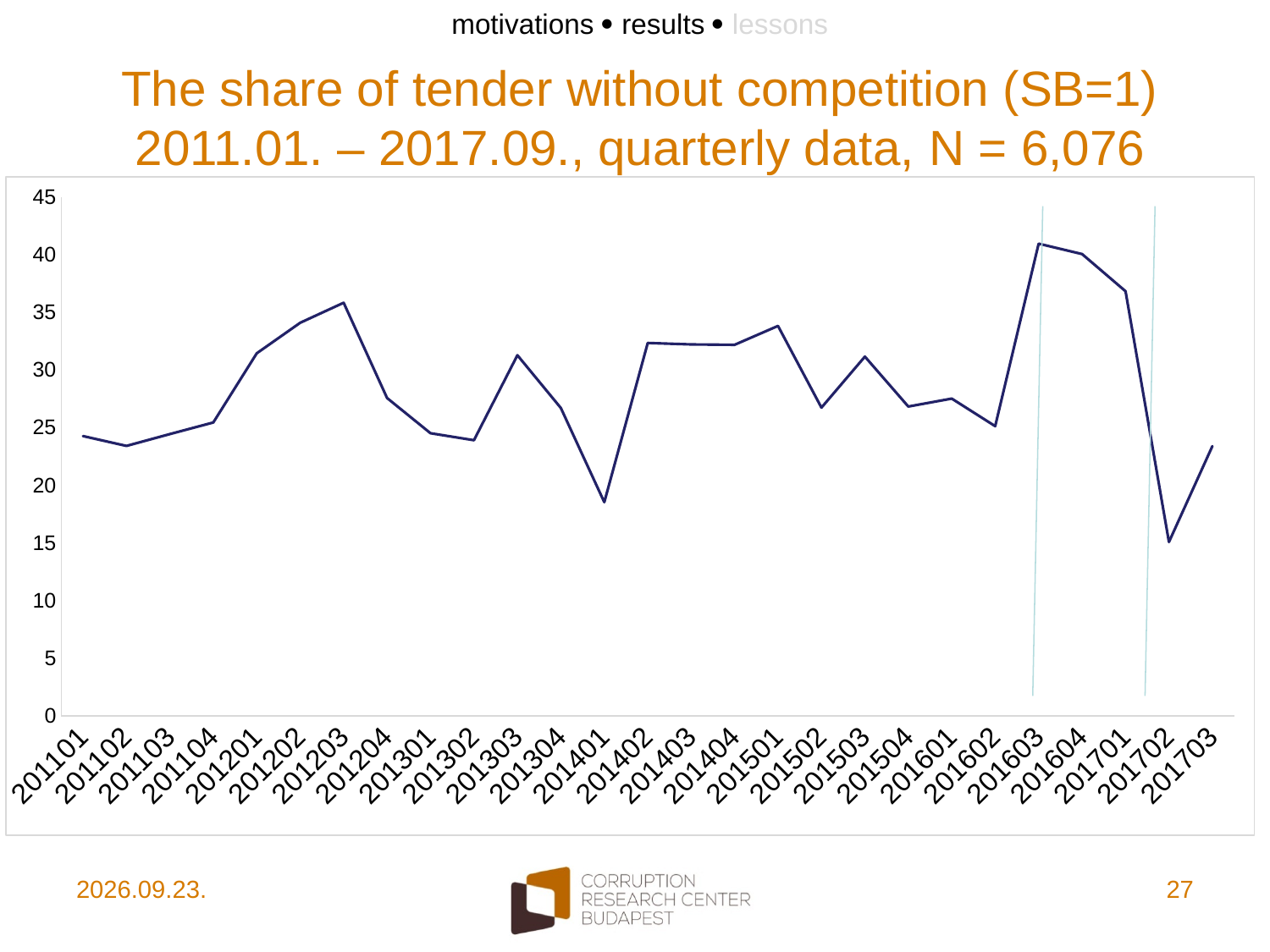
What is the title of the chart? The share of tender without competition (SB=1) 2011.01. – 2017.09., quarterly data, N = 6,076 Which quarter has the lowest share of tenders without competition? 201702 How many quarterly data points are plotted on the chart? 27 Is the value for 201101 greater or less than 25? less Is the value for 201603 greater or less than 40? greater Which quarter has the highest share of tenders without competition? 201603 Do the values rise or fall from 201603 to 201702? fall Is the value for 201702 greater or less than 20? less Which is larger, the value for 201203 or the value for 201401? 201203 What kind of chart is shown on the slide? line chart